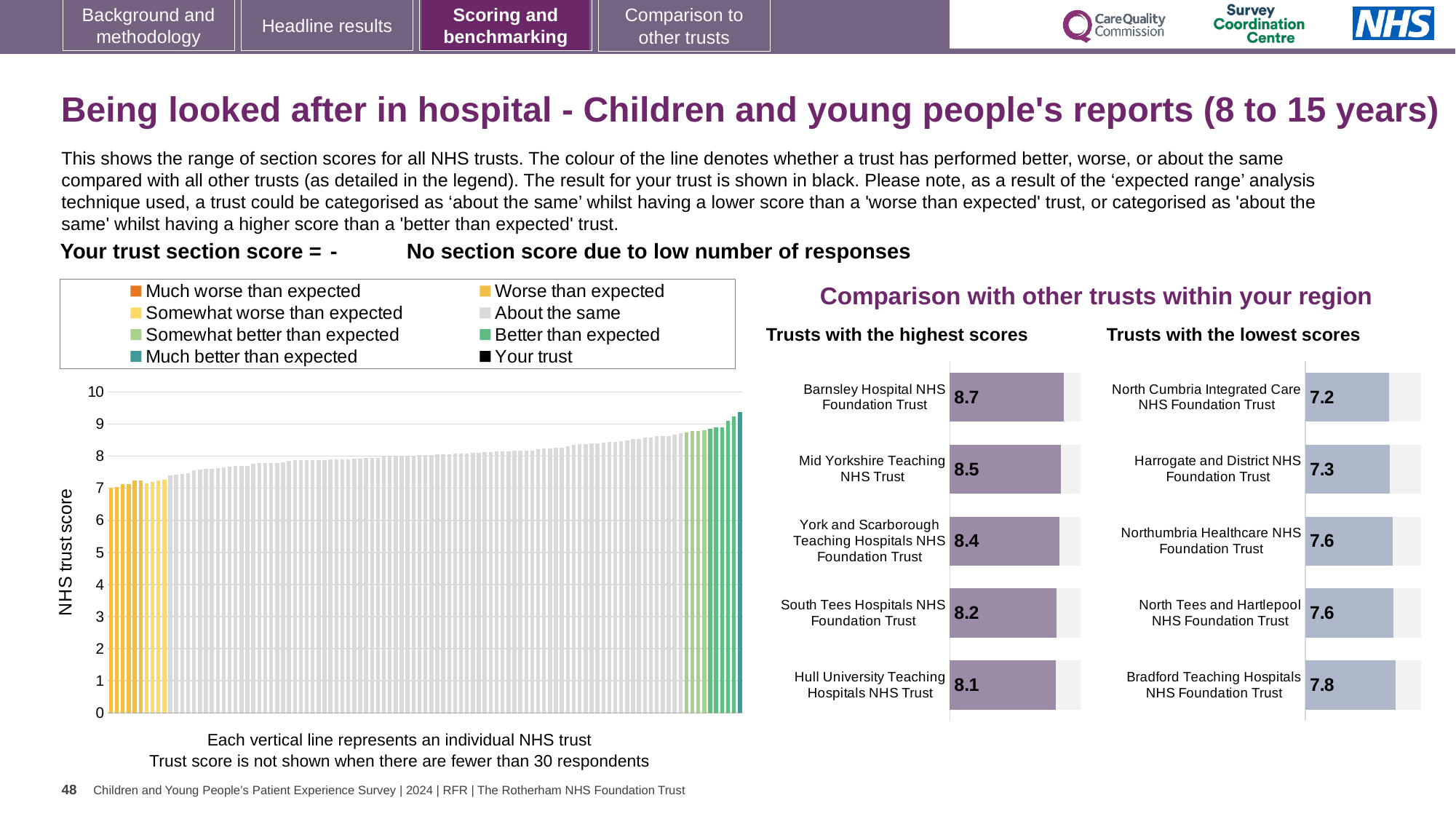
In the main 'NHS trust score' chart on the left, do the bar values rise or fall from left to right? rise In the 'Trusts with the highest scores' chart, which has the higher score: Mid Yorkshire Teaching NHS Trust or York and Scarborough Teaching Hospitals NHS Foundation Trust? Mid Yorkshire Teaching NHS Trust In the 'Trusts with the highest scores' chart, which trust has the lowest score shown? Hull University Teaching Hospitals NHS Trust In the 'Trusts with the lowest scores' chart, what score is shown for Northumbria Healthcare NHS Foundation Trust? 7.6 In the 'Trusts with the lowest scores' chart, what is the score for North Cumbria Integrated Care NHS Foundation Trust? 7.2 In the 'Trusts with the lowest scores' chart, what is the difference between the scores of Bradford Teaching Hospitals NHS Foundation Trust and Harrogate and District NHS Foundation Trust? 0.5 In the 'Trusts with the lowest scores' chart, which trust has the highest score shown? Bradford Teaching Hospitals NHS Foundation Trust How many trusts are listed in the 'Trusts with the lowest scores' chart? 5 In the main 'NHS trust score' chart on the left, is the value of the lowest bar greater or less than 5? greater In the 'Trusts with the highest scores' chart, what is the score for Barnsley Hospital NHS Foundation Trust? 8.7 How many entries does the legend above the main 'NHS trust score' chart list? 8 In the 'Trusts with the highest scores' chart, what is the difference between the scores of Barnsley Hospital NHS Foundation Trust and South Tees Hospitals NHS Foundation Trust? 0.5